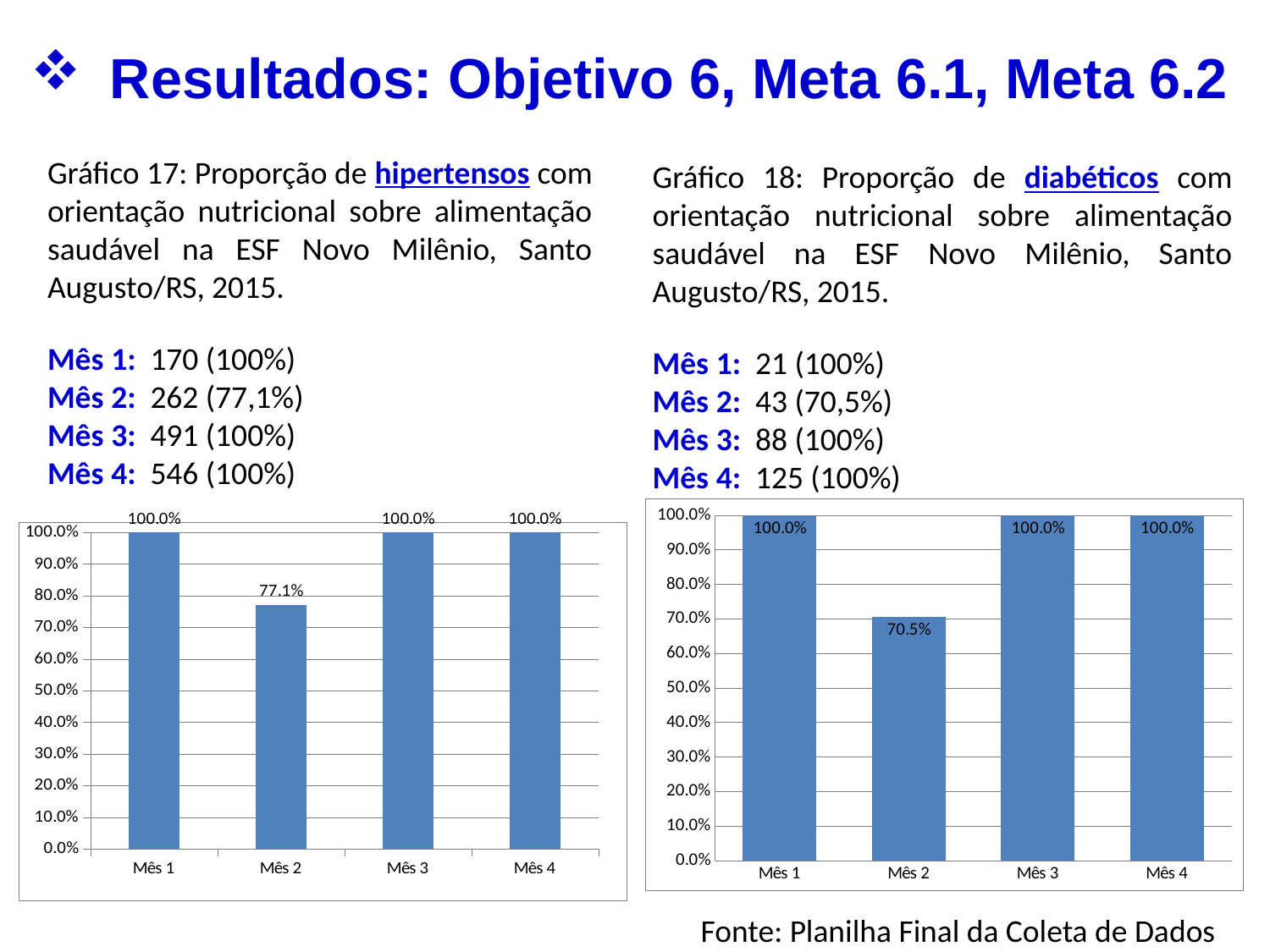
In Gráfico 18 (diabéticos, right chart), what is the value for Mês 2? 70.5% In Gráfico 17 (left chart), which month has the lowest value? Mês 2 In Gráfico 17 (hipertensos, left chart), what is the value for Mês 2? 77.1% In Gráfico 18 (right chart), what is the difference between the values for Mês 3 and Mês 2? 29.5% In Gráfico 18 (right chart), which month has the lowest value? Mês 2 In Gráfico 18 (right chart), is the value for Mês 2 greater or less than 80.0%? less What type of chart is Gráfico 17 (left chart)? Bar chart Which is larger: the Mês 2 value in Gráfico 17 (left chart) or the Mês 2 value in Gráfico 18 (right chart)? Gráfico 17 (77.1%) In Gráfico 17 (left chart), what is the difference between the values for Mês 1 and Mês 2? 22.9% In Gráfico 17 (left chart), what is the value for Mês 3? 100.0% In Gráfico 18 (right chart), what is the value for Mês 4? 100.0% How many months (categories) are shown in Gráfico 18 (right chart)? 4